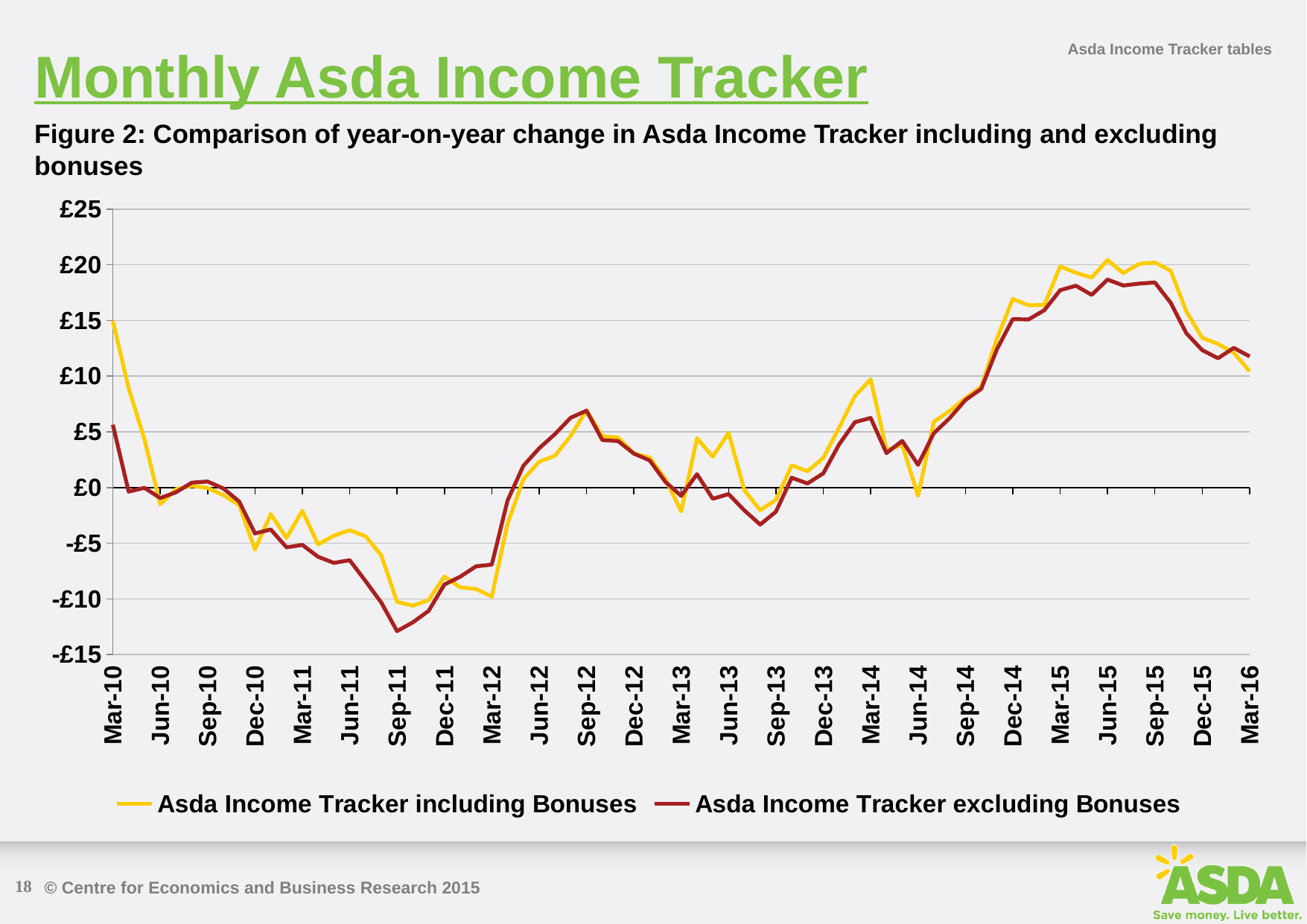
Is the value for Asda Income Tracker excluding Bonuses at Mar-16 greater or less than £10? greater What kind of chart is shown on the slide? Line chart Is the value for Asda Income Tracker excluding Bonuses at Mar-12 greater or less than -£5? less Between Sep-13 and Mar-15, does the Asda Income Tracker including Bonuses series generally rise or fall? Rise Is the value for Asda Income Tracker excluding Bonuses at Sep-11 greater or less than -£10? less At Mar-10, which series has the higher value: including Bonuses or excluding Bonuses? Asda Income Tracker including Bonuses How many series does the legend list? 2 At Mar-16, which series has the higher value: including Bonuses or excluding Bonuses? Asda Income Tracker excluding Bonuses At which x-axis date does the Asda Income Tracker excluding Bonuses series reach its lowest value? Sep-11 What are the two series named in the legend? Asda Income Tracker including Bonuses; Asda Income Tracker excluding Bonuses How many date labels are shown along the x axis? 25